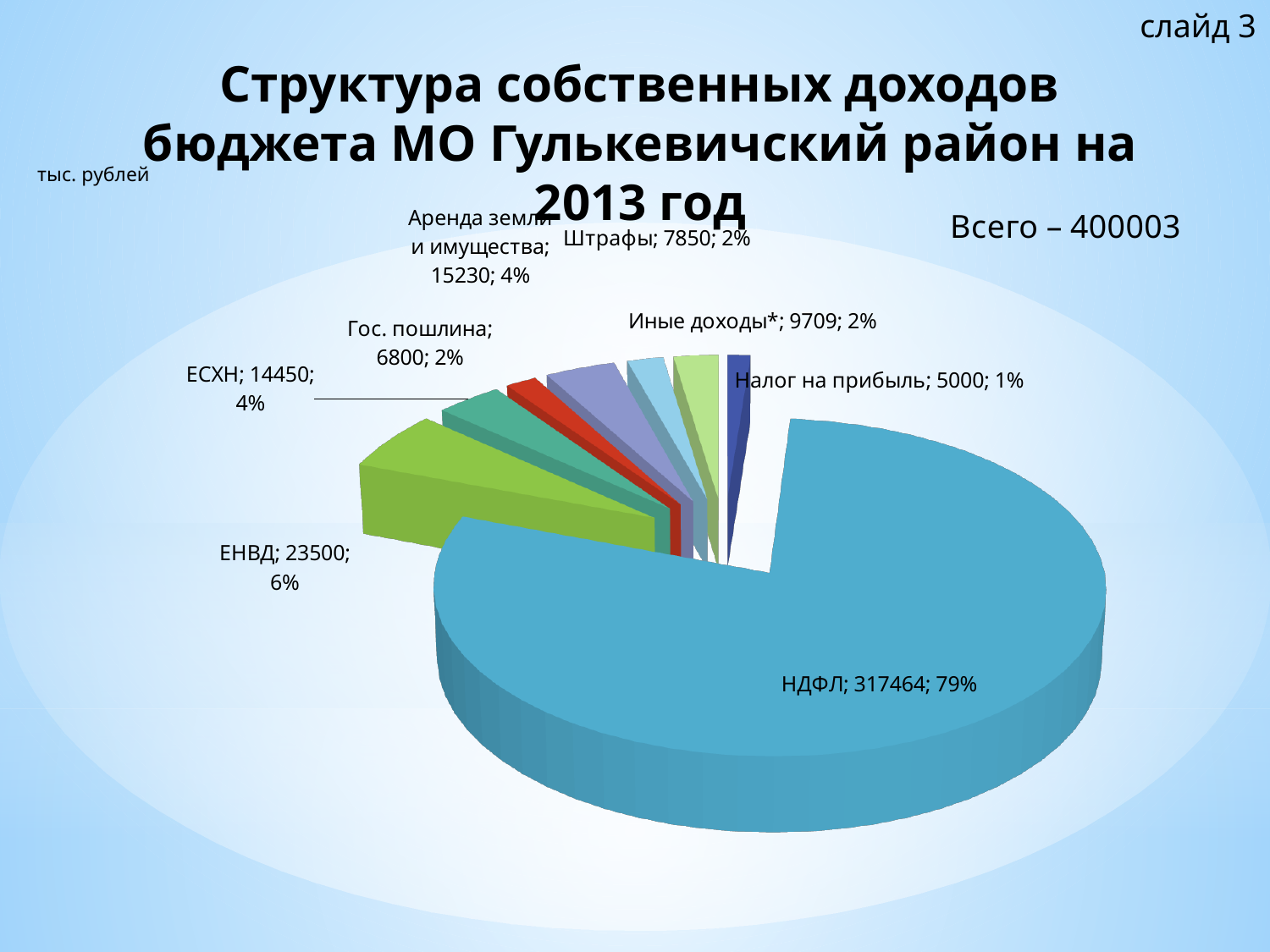
Which category has the largest value? НДФЛ Which category has the smallest value? Налог на прибыль What is the value for Гос. пошлина? 6800 What is the value for ЕНВД? 23500 What is the difference between the values for ЕНВД and ЕСХН? 9050 Which is larger, the value for Штрафы or the value for Иные доходы*? Иные доходы* What total is stated on the slide for the chart (Всего)? 400003 What is the value for НДФЛ? 317464 How many categories (slices) does the pie chart show? 8 What share of the pie does НДФЛ account for? 79% What share of the pie does Аренда земли и имущества account for? 4% What kind of chart is shown on the slide? Pie chart